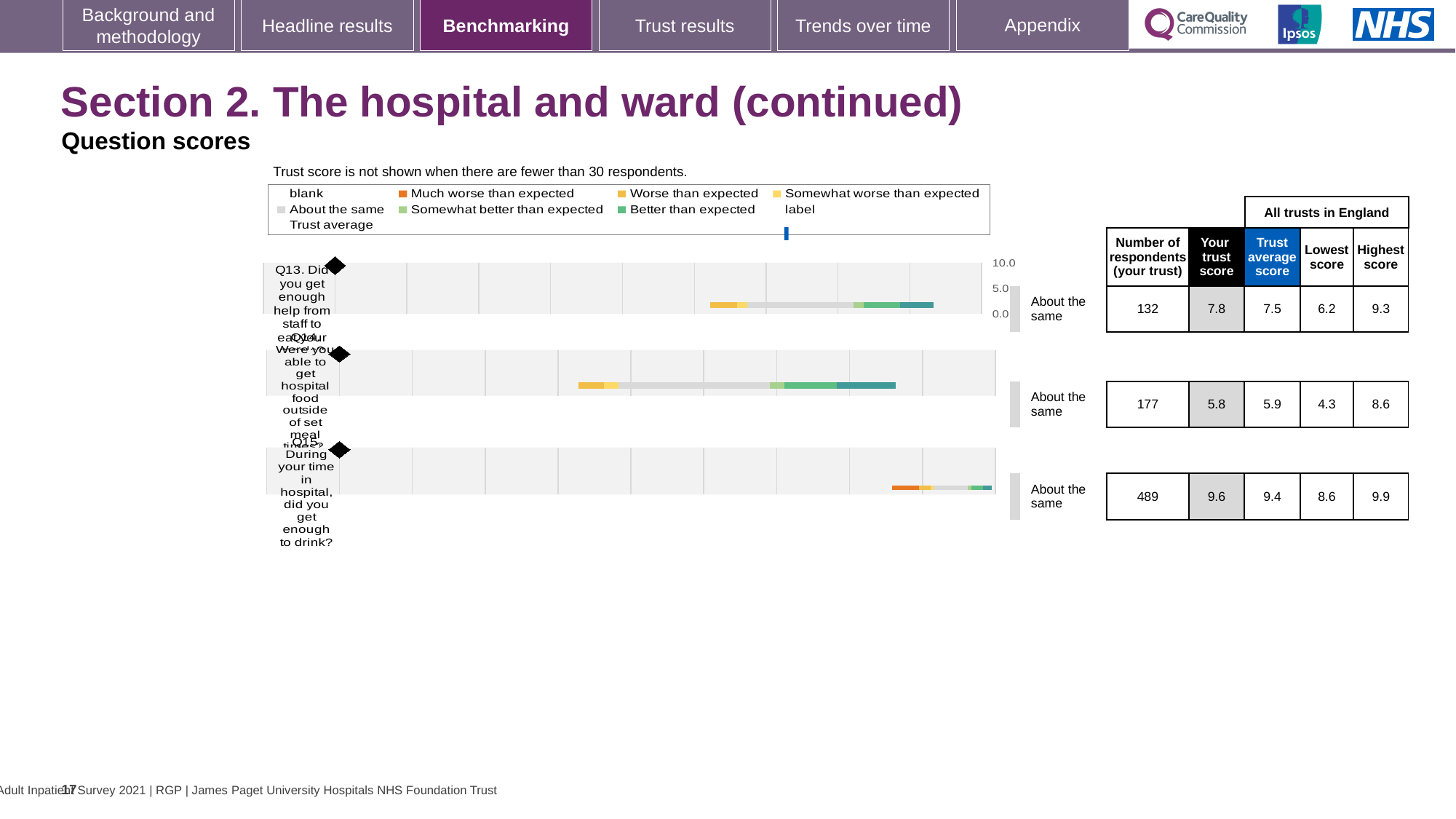
Which of the three questions shown has the fewest respondents from your trust? Q13 What benchmark category is shown for Q13? About the same For Q13, what is the difference between your trust score and the trust average score? 0.3 Which of the three questions shown has the highest 'Your trust score'? Q15 What is the highest score across all trusts in England for Q15? 9.9 For Q14, which is larger: your trust score or the trust average score? Trust average score How many respondents from your trust answered Q15 (did you get enough to drink?)? 489 What is the trust average score for Q14 (Were you able to get hospital food outside of set meal times?)? 5.9 What kind of chart is used to show the question scores on this slide? Bar chart What is the lowest score across all trusts in England for Q14? 4.3 What is the 'Your trust score' for Q13 (Did you get enough help from staff to eat your meals?)? 7.8 How many questions are plotted on this slide? 3